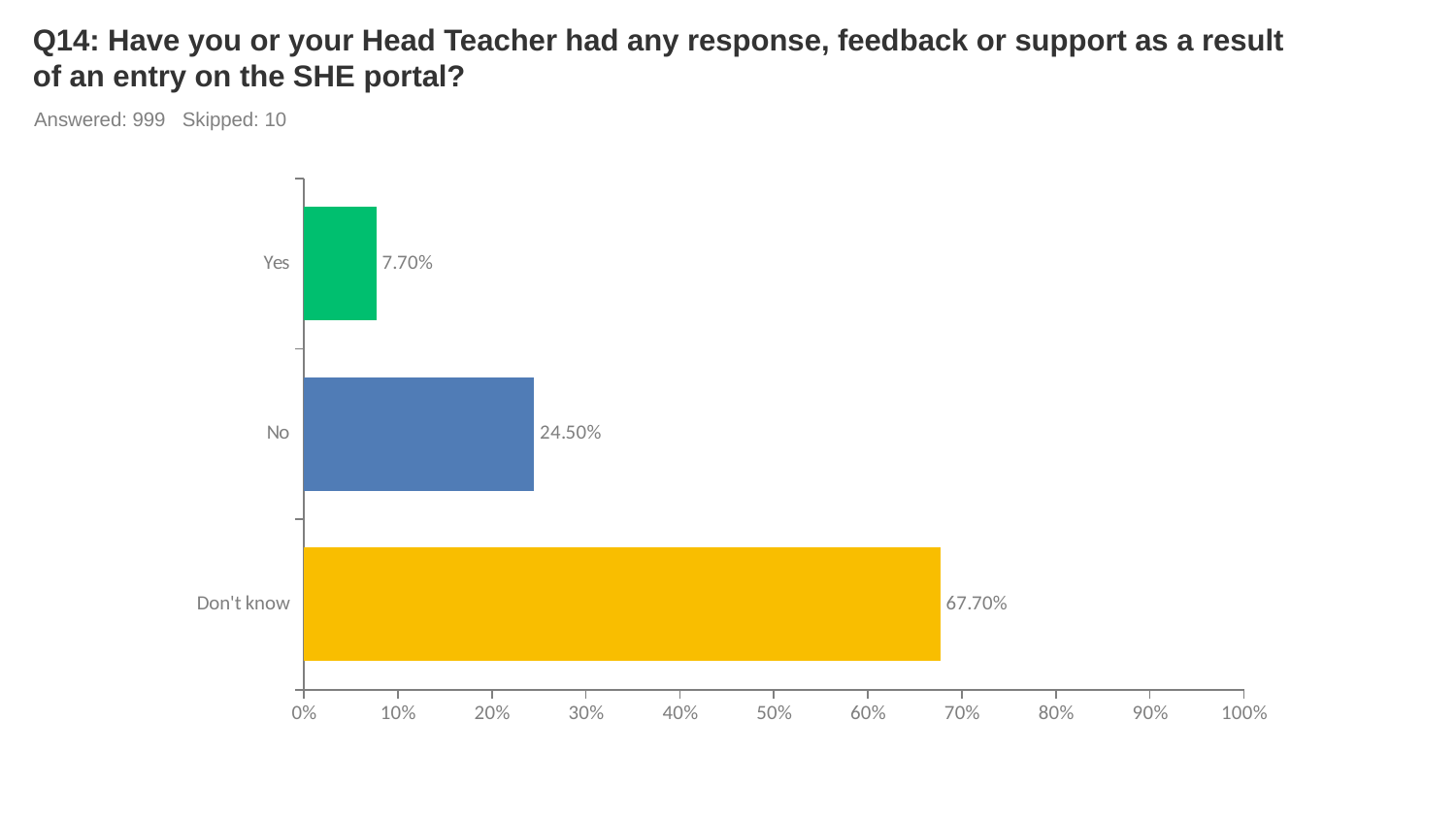
What percentage of respondents answered "Don't know"? 67.70% What is the difference in percentage points between "Don't know" and "No"? 43.20% What is the difference in percentage points between "No" and "Yes"? 16.80% Is the value for "Don't know" greater or less than 60%? greater How many response categories are shown in the chart? 3 What kind of chart is shown on the slide? Bar chart How many respondents answered this question? 999 What percentage of respondents answered "No"? 24.50% Which response has the lowest percentage? Yes Which is larger, the percentage for "No" or for "Yes"? No What percentage of respondents answered "Yes"? 7.70% Which response has the highest percentage? Don't know